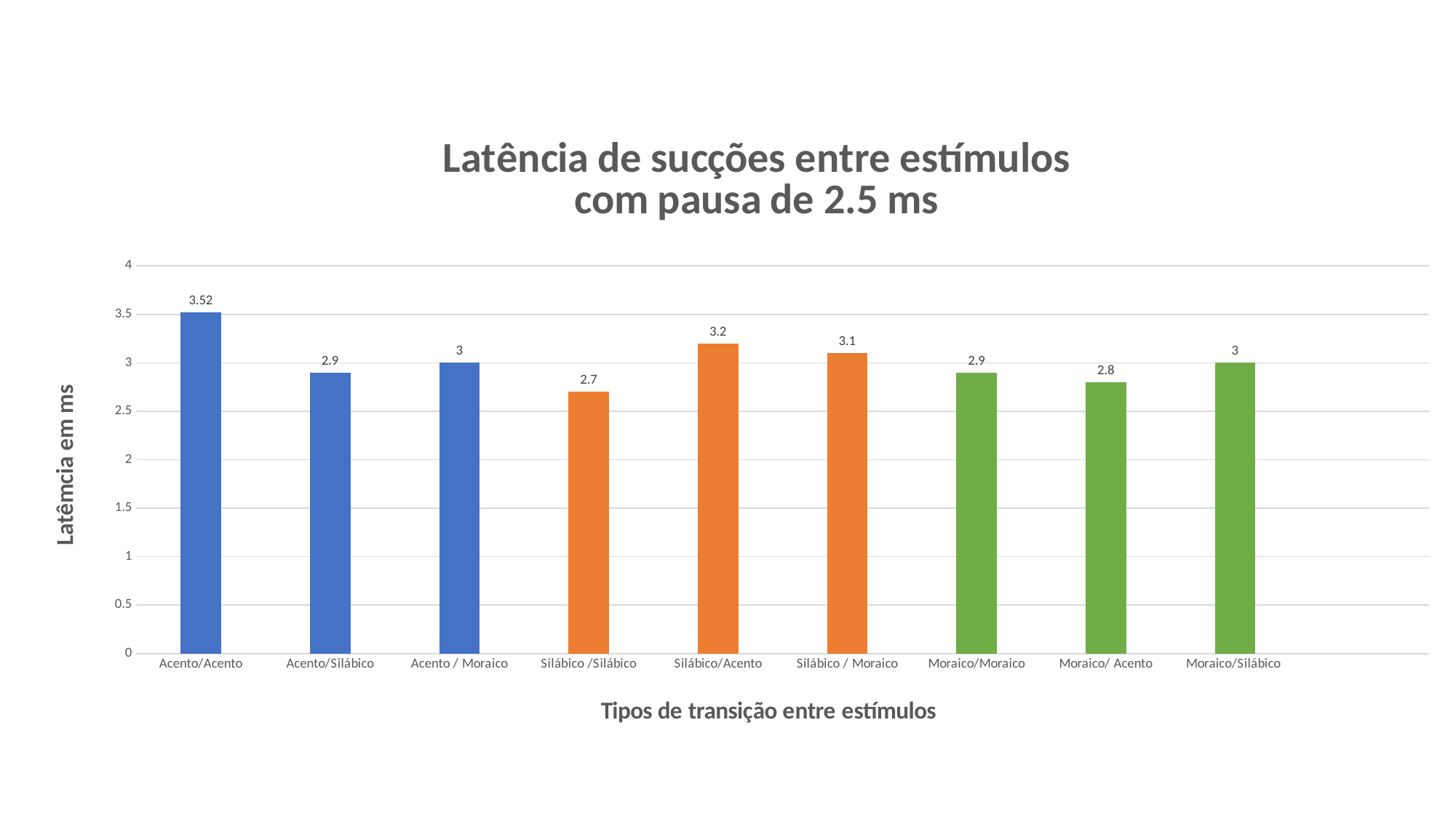
Is the value for Acento/Acento greater or less than 3.5? greater What is the difference between the values for Acento/Acento and Silábico /Silábico? 0.82 What is the value for Acento/Acento? 3.52 What is the title of the chart? Latência de sucções entre estímulos com pausa de 2.5 ms Which is larger, the value for Silábico/Acento or the value for Moraico/Moraico? Silábico/Acento What kind of chart is this? bar chart What is the difference between the values for Silábico/Acento and Silábico / Moraico? 0.1 Which category has the lowest value? Silábico /Silábico Which category has the highest value? Acento/Acento What is the value for Silábico /Silábico? 2.7 What is the value for Moraico/ Acento? 2.8 How many categories are shown on the x axis? 9